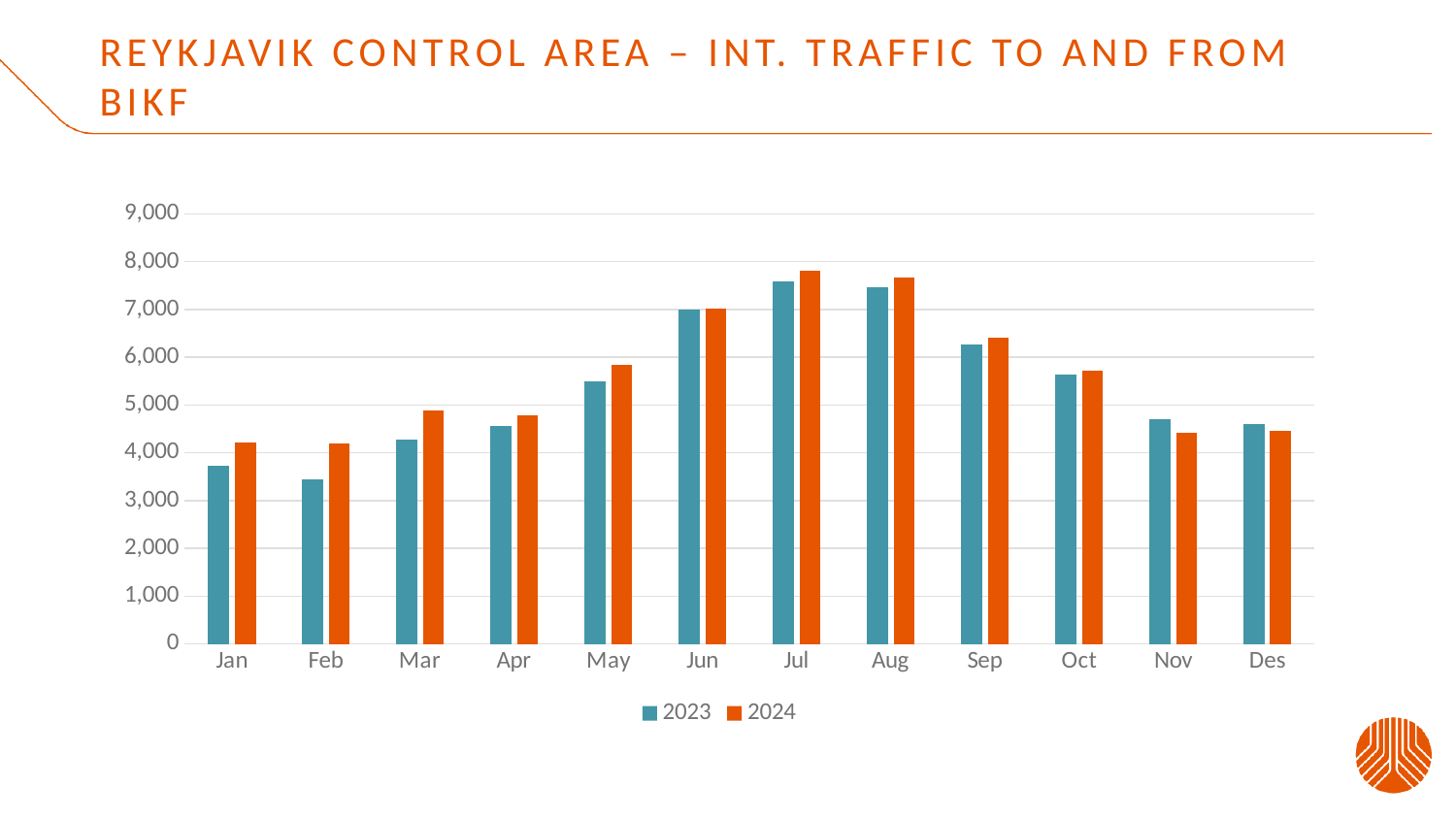
How many series does the legend list? 2 Is the 2024 value for Mar greater or less than 5,000? less Which month has the lowest value for the 2023 series? Feb In Feb, which series has the larger value, 2023 or 2024? 2024 Is the 2023 value for Jan greater or less than 4,000? less In Nov, which series has the larger value, 2023 or 2024? 2023 Do the 2023 values rise or fall from Jan to Jul? rise Is the 2024 value for Jul greater or less than 8,000? less How many months are shown on the x axis? 12 What kind of chart is shown on the slide? Bar chart Which month has the highest value for the 2024 series? Jul